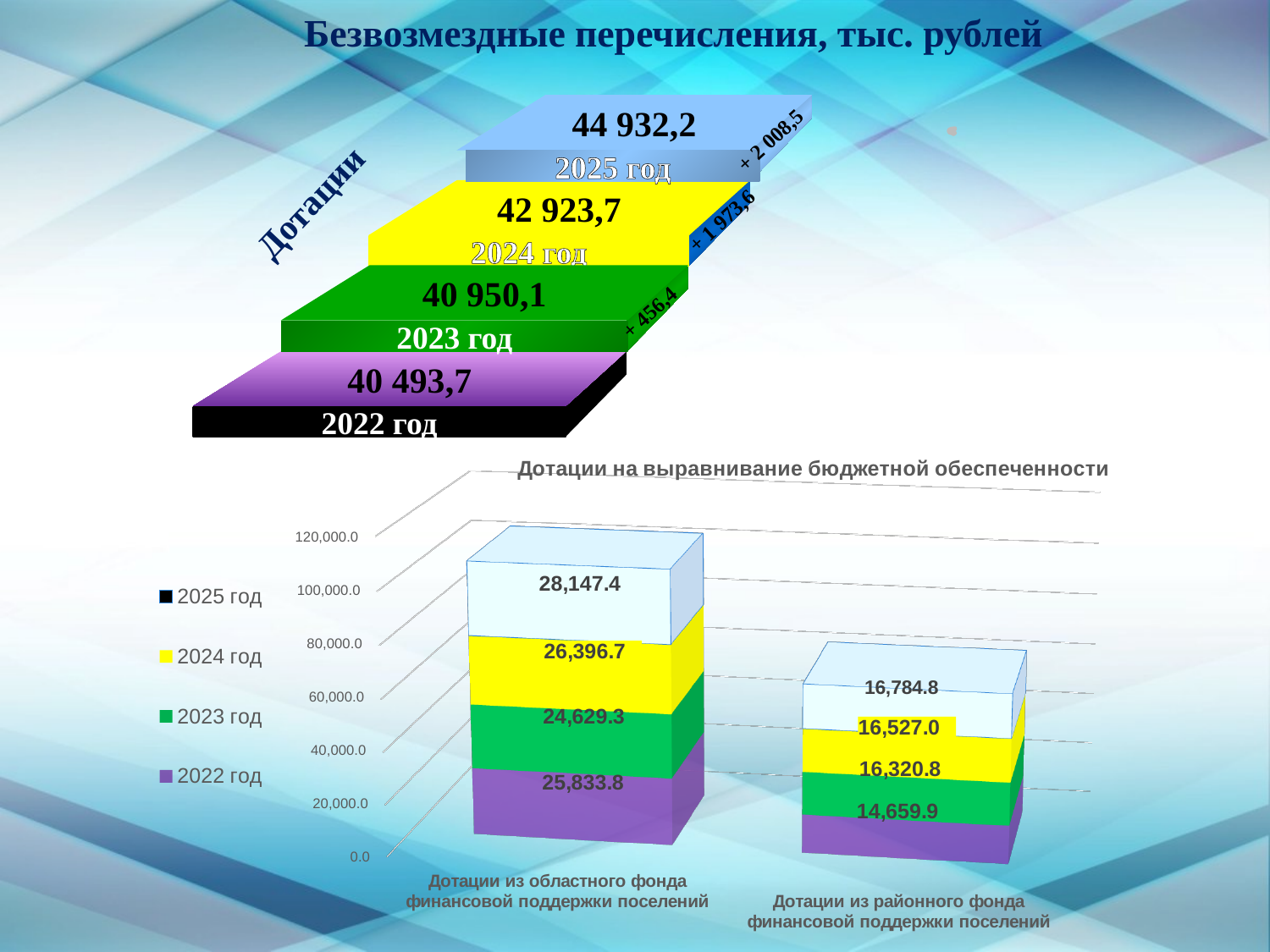
What kind of chart is the bottom chart 'Дотации на выравнивание бюджетной обеспеченности'? stacked bar chart In the top chart 'Дотации', which year has the highest value? 2025 год In the bottom chart 'Дотации на выравнивание бюджетной обеспеченности', what is the total of the stacked bar for 'Дотации из районного фонда финансовой поддержки поселений'? 64,292.5 In the bottom chart 'Дотации на выравнивание бюджетной обеспеченности', what is the 2025 год value for 'Дотации из областного фонда финансовой поддержки поселений'? 28,147.4 In the bottom chart 'Дотации на выравнивание бюджетной обеспеченности', which category has the larger 2025 год value? Дотации из областного фонда финансовой поддержки поселений In the top chart 'Дотации', do the values rise or fall from 2022 год to 2025 год? rise In the top chart 'Дотации', what is the value for 2022 год? 40 493,7 In the bottom chart 'Дотации на выравнивание бюджетной обеспеченности', what is the 2022 год value for 'Дотации из районного фонда финансовой поддержки поселений'? 14,659.9 In the top chart 'Дотации', what is the value for 2025 год? 44 932,2 In the bottom chart 'Дотации на выравнивание бюджетной обеспеченности', what is the difference between the 2024 год and 2023 год values for 'Дотации из областного фонда финансовой поддержки поселений'? 1,767.4 In the bottom chart 'Дотации на выравнивание бюджетной обеспеченности', how many series does the legend list? 4 In the top chart 'Дотации', what is the difference between the 2025 год and 2022 год values? 4 438,5